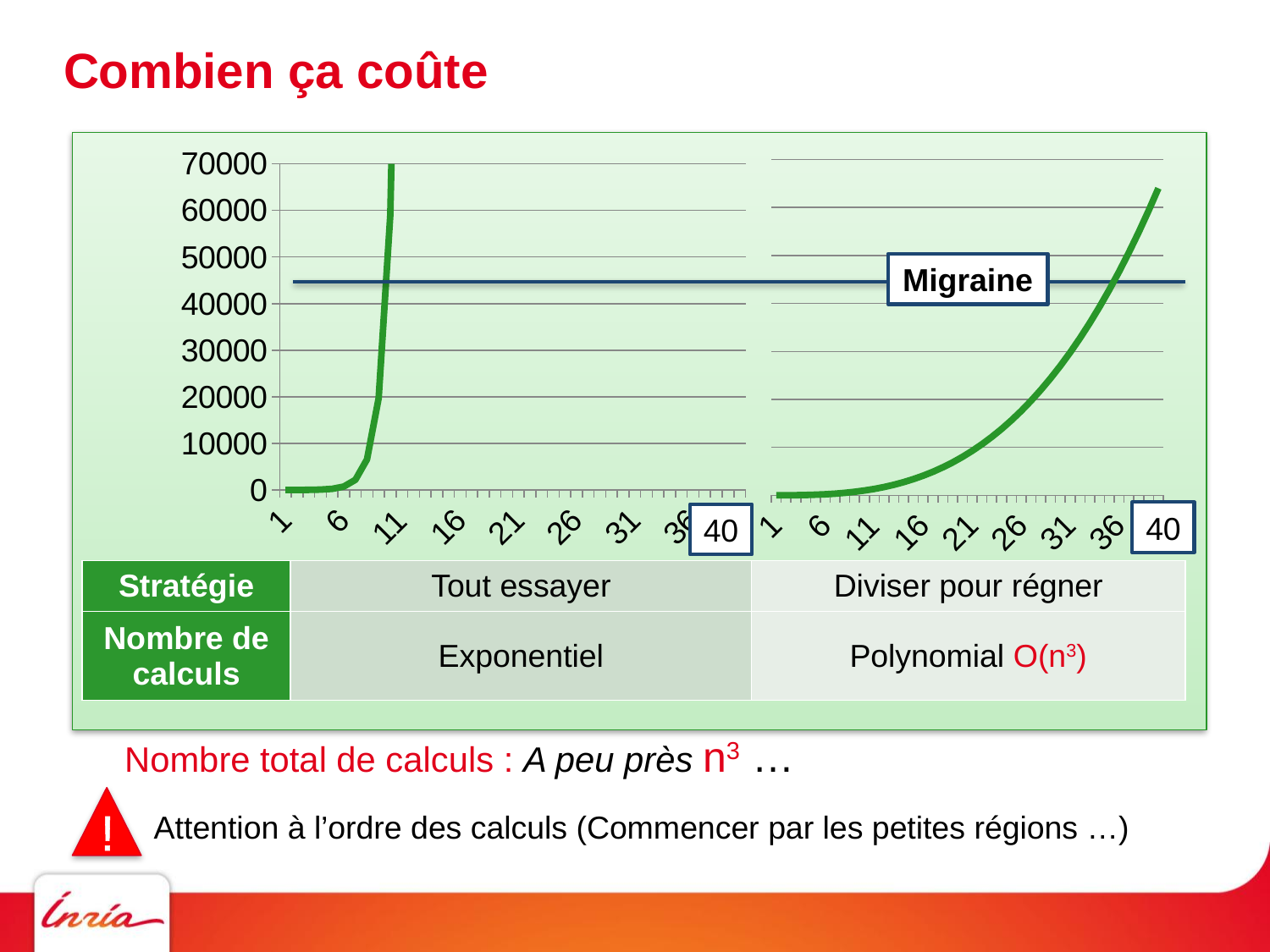
Which strategy's curve reaches the Migraine line first (at a smaller x value)? Tout essayer In the right chart (Diviser pour régner), is the value at x = 40 greater or less than 60000? greater In the right chart (Diviser pour régner), is the value at x = 16 greater or less than 10000? less In the right chart (Diviser pour régner), is the value at x = 36 greater or less than 40000? greater In the right chart (Diviser pour régner), do the values rise or fall along the x axis? Rise At x = 11, which chart shows the larger value: the left chart (Tout essayer) or the right chart (Diviser pour régner)? Left chart (Tout essayer) In the left chart (Tout essayer), do the values rise or fall as the x axis goes from 1 to 40? Rise What kind of chart is used on the slide to show the number of calculations? Line chart What is the highest value shown on the y axis of the charts? 70000 What label is given to the horizontal line drawn across both charts? Migraine